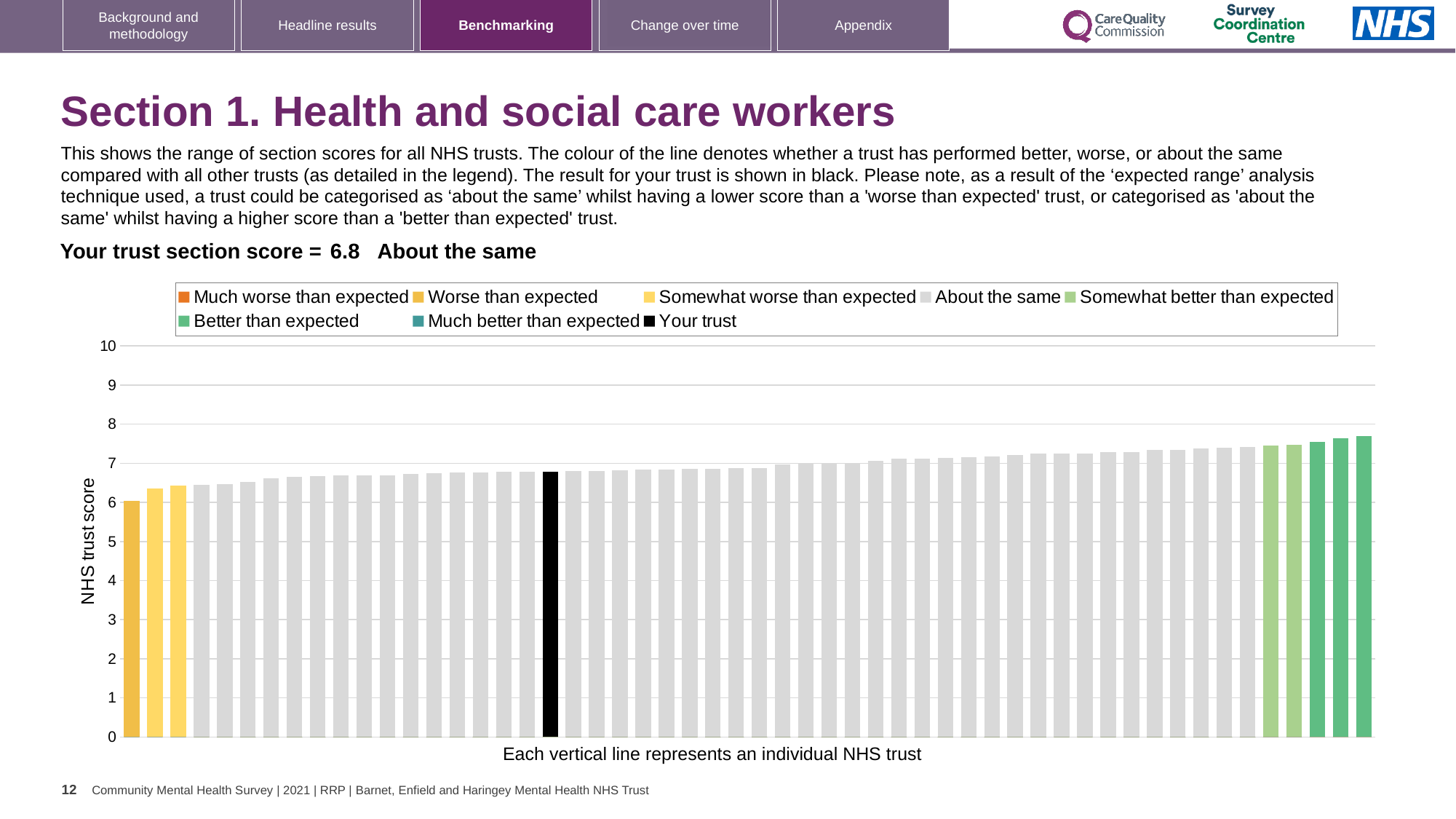
Is the value of the shortest bar greater or less than 7? less Is the value for the black 'Your trust' bar greater or less than 7? less What is the section score for your trust shown on the slide? 6.8 Is the value for the black 'Your trust' bar greater or less than 6? greater How many entries does the chart legend list? 8 How many bars are coloured as 'Worse than expected'? 1 What is the label on the y axis of the chart? NHS trust score Do the bar values rise or fall from left to right along the x axis? rise What kind of chart is shown on the slide? bar chart How many bars are coloured as 'Better than expected'? 3 What category is your trust placed in according to the slide? About the same